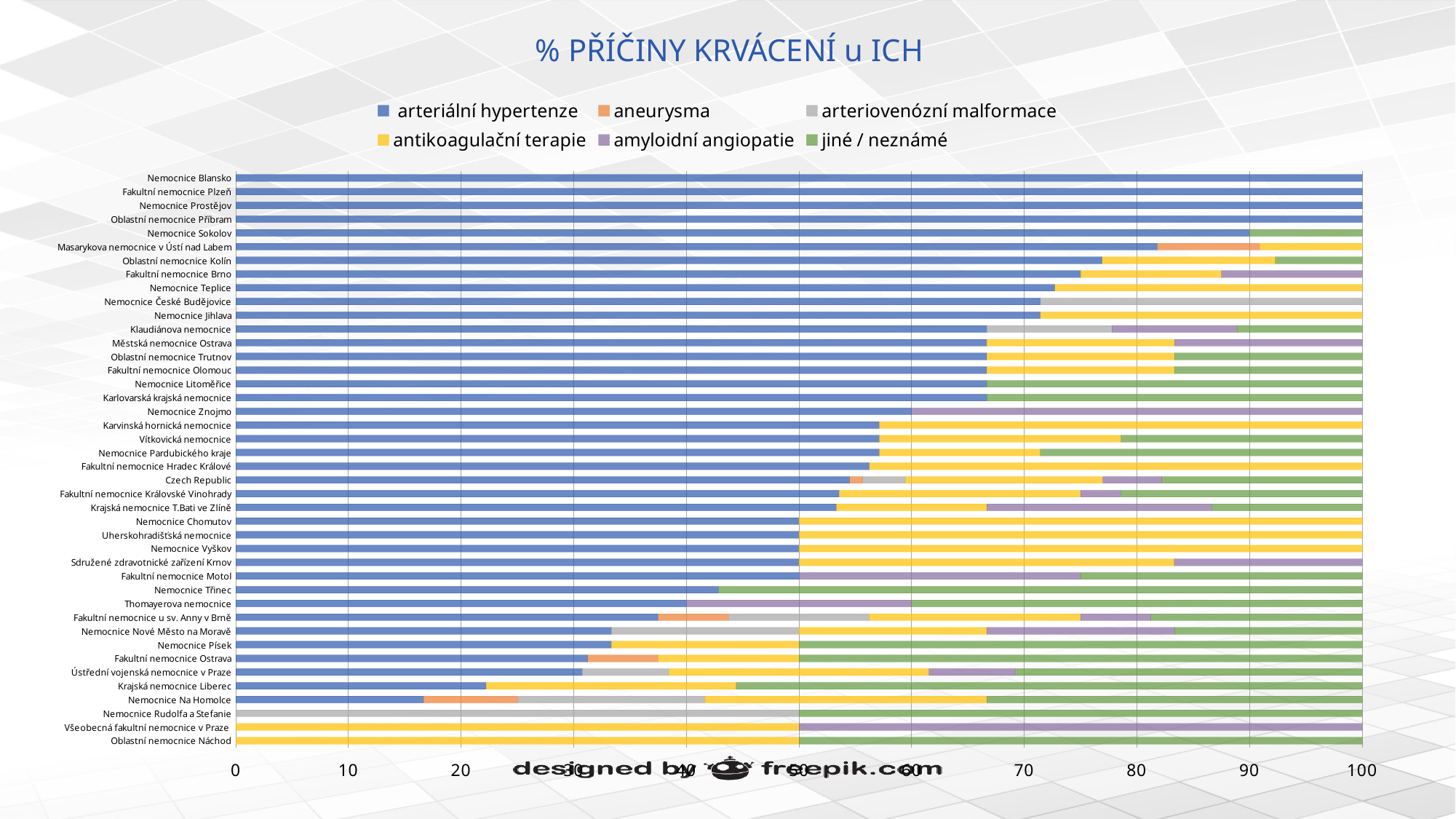
What is the value of 'arteriální hypertenze' for Nemocnice Chomutov? 50 Is the value of 'arteriální hypertenze' for Nemocnice Sokolov greater or less than 80? greater Is the value of 'arteriální hypertenze' for Nemocnice Na Homolce greater or less than 20? less Which has a larger 'arteriální hypertenze' value, Nemocnice Sokolov or Nemocnice Znojmo? Nemocnice Sokolov How many hospitals (categories) are plotted on the chart? 42 What is the value of 'antikoagulační terapie' for Oblastní nemocnice Náchod? 50 What is the title of the chart? % PŘÍČINY KRVÁCENÍ u ICH How many series does the legend list? 6 Which colour represents 'aneurysma' in the legend? Orange Which has a larger 'arteriální hypertenze' value, Nemocnice Třinec or Nemocnice Na Homolce? Nemocnice Třinec What is the value of 'arteriální hypertenze' for Nemocnice Blansko? 100 What kind of chart is shown on the slide? Stacked bar chart